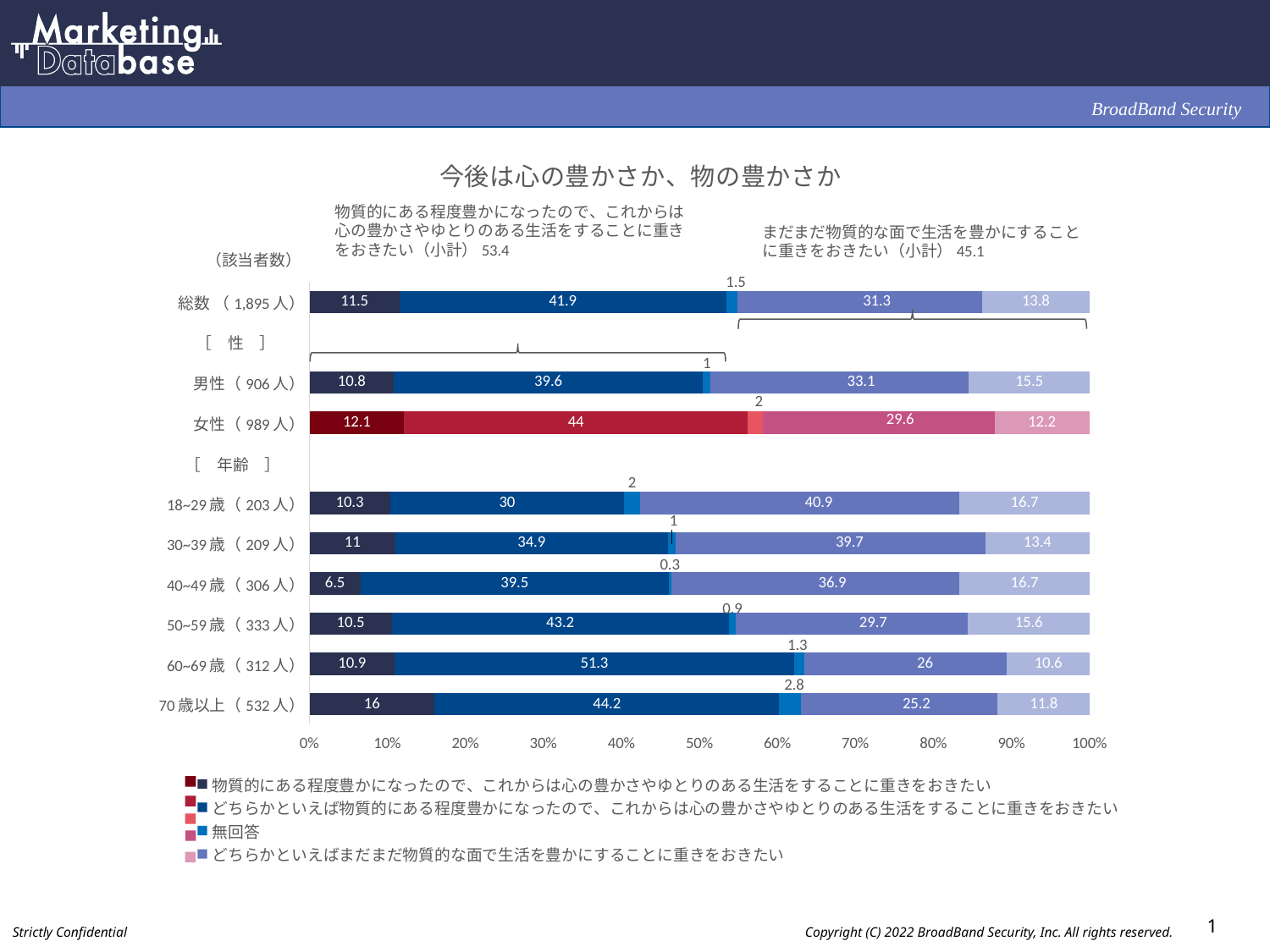
What is the subtotal (小計) shown for 'まだまだ物質的な面で生活を豊かにすることに重きをおきたい'? 45.1 What is the value of the fourth segment (どちらかといえばまだまだ物質的な面で…) for 18~29歳? 40.9 What is the title of the chart? 今後は心の豊かさか、物の豊かさか What is the total of all segments in the 総数 bar? 100 What is the value of the second segment (どちらかといえば物質的にある程度豊かになったので…心の豊かさ…) for 60~69歳? 51.3 Which has a larger value for the fourth segment (どちらかといえばまだまだ物質的な面で…): 30~39歳 or 50~59歳? 30~39歳 Which group has the lowest value for the first segment (物質的にある程度豊かになったので…心の豊かさ…)? 40~49歳 What is the difference between the second-segment values for 女性 (44) and 男性 (39.6)? 4.4 Which group has the highest value for the first segment (物質的にある程度豊かになったので…心の豊かさ…)? 70歳以上 What kind of chart is shown on the slide? stacked bar chart How many respondent groups (bars) are plotted in the chart? 9 What is the value of the 無回答 segment for 40~49歳? 0.3